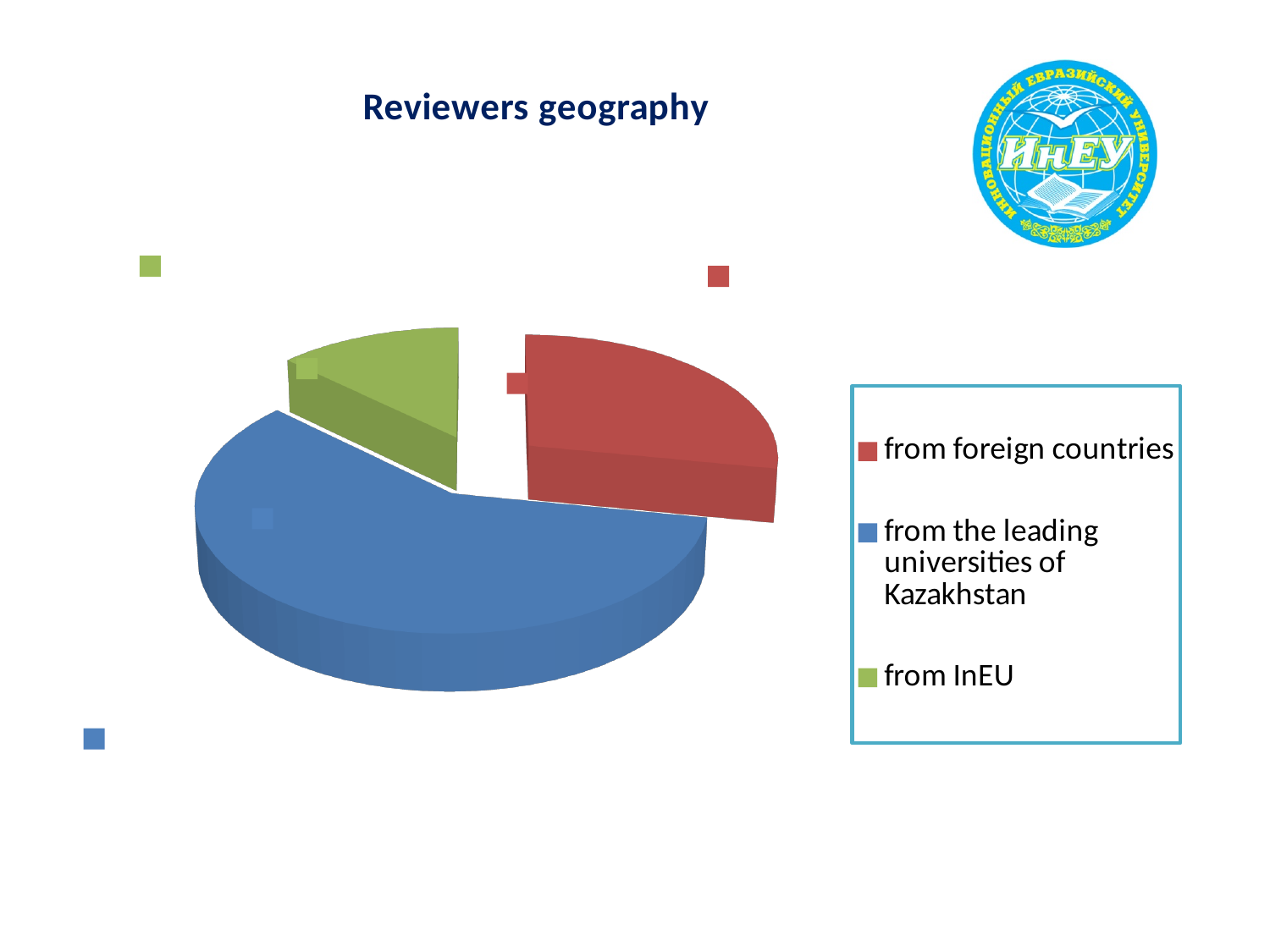
Which category is shown in red in the pie chart? from foreign countries How many slices does the pie chart have? 3 How many entries does the legend list? 3 Which is larger: the share for 'from the leading universities of Kazakhstan' or the share for 'from foreign countries'? from the leading universities of Kazakhstan Which is larger: the share for 'from foreign countries' or the share for 'from InEU'? from foreign countries Which category has the largest share of the pie? from the leading universities of Kazakhstan Which colour represents 'from InEU' in the pie chart? green Which category has the smallest share of the pie? from InEU What is the title of the chart? Reviewers geography What kind of chart is shown on the slide? pie chart